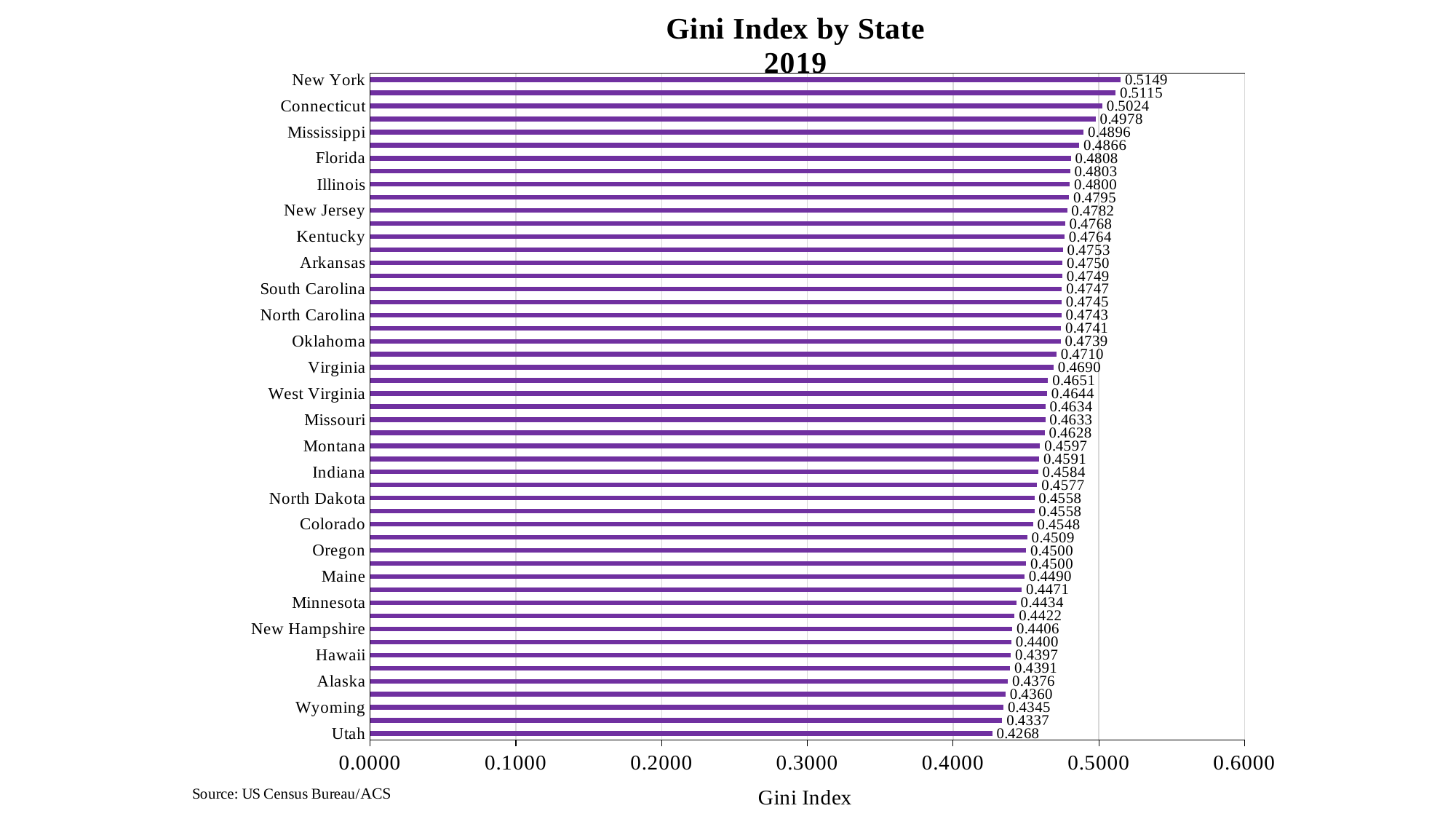
What is the Gini Index value for Florida? 0.4808 What is the Gini Index value for New York? 0.5149 What is the title of the chart? Gini Index by State 2019 Is the Gini Index for Connecticut greater or less than 0.5000? greater What is the Gini Index value for Colorado? 0.4548 What is the Gini Index value for Utah? 0.4268 Which has a higher Gini Index, Mississippi or Minnesota? Mississippi Which state has the highest Gini Index on the chart? New York Do the bar values rise or fall going from the top of the chart to the bottom? Fall What kind of chart is shown on the slide? Bar chart What is the difference between the Gini Index of New York and Utah? 0.0881 Which state has the lowest Gini Index on the chart? Utah